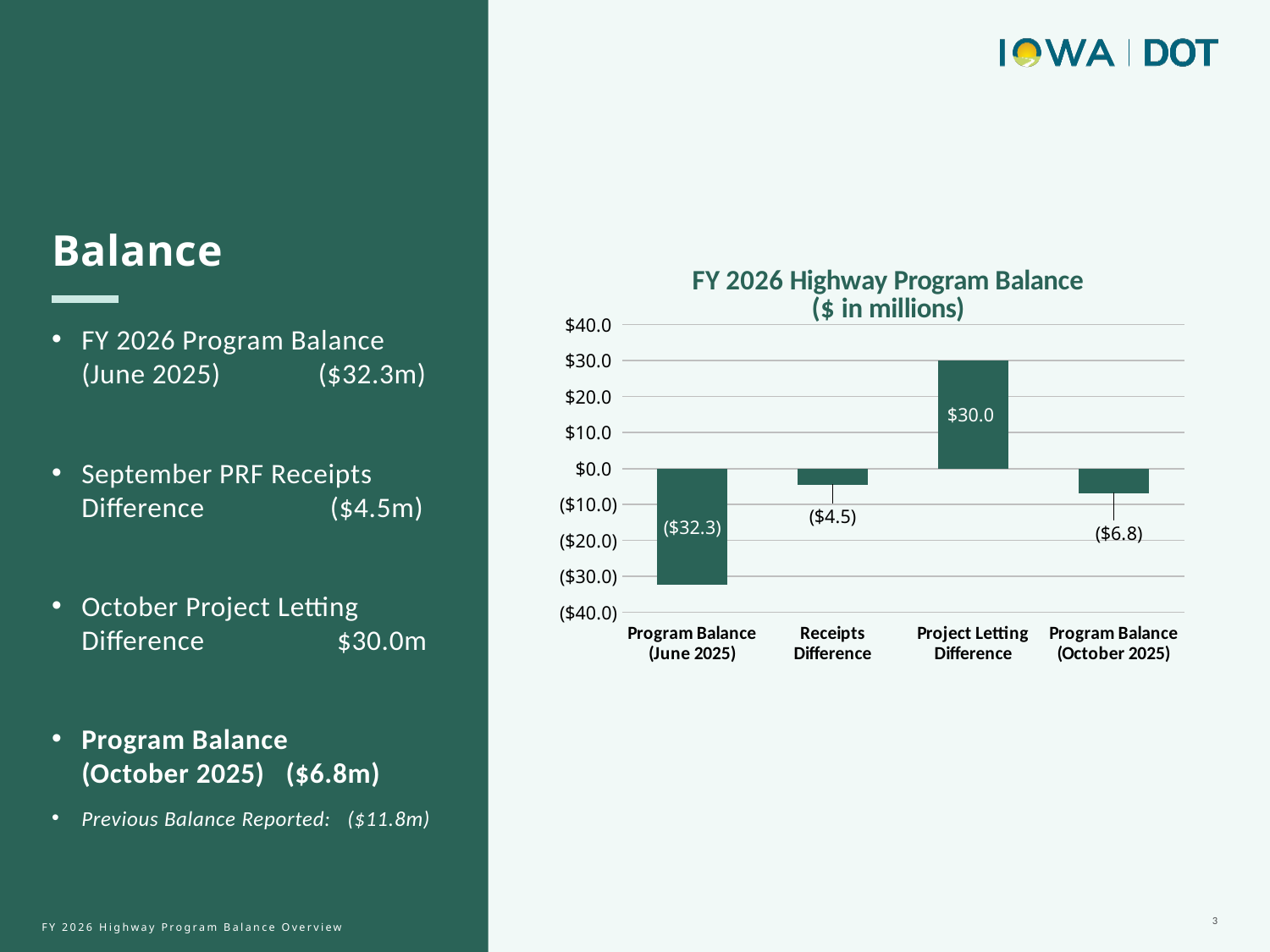
What is the value for Program Balance (June 2025) in the FY 2026 Highway Program Balance chart? ($32.3) Which category has the highest value in the chart? Project Letting Difference What is the value for Project Letting Difference in the chart? $30.0 Which category has the lowest value in the chart? Program Balance (June 2025) What is the value for Receipts Difference in the chart? ($4.5) What is the value for Program Balance (October 2025) in the chart? ($6.8) What kind of chart is shown on the slide? Bar chart What is the difference between the value for Project Letting Difference and the value for Receipts Difference? $34.5 What is the title of the chart? FY 2026 Highway Program Balance ($ in millions) Which is larger, the value for Receipts Difference or the value for Program Balance (October 2025)? Receipts Difference Is the value for Program Balance (June 2025) greater or less than ($30.0)? less How many categories are shown on the x axis of the chart? 4